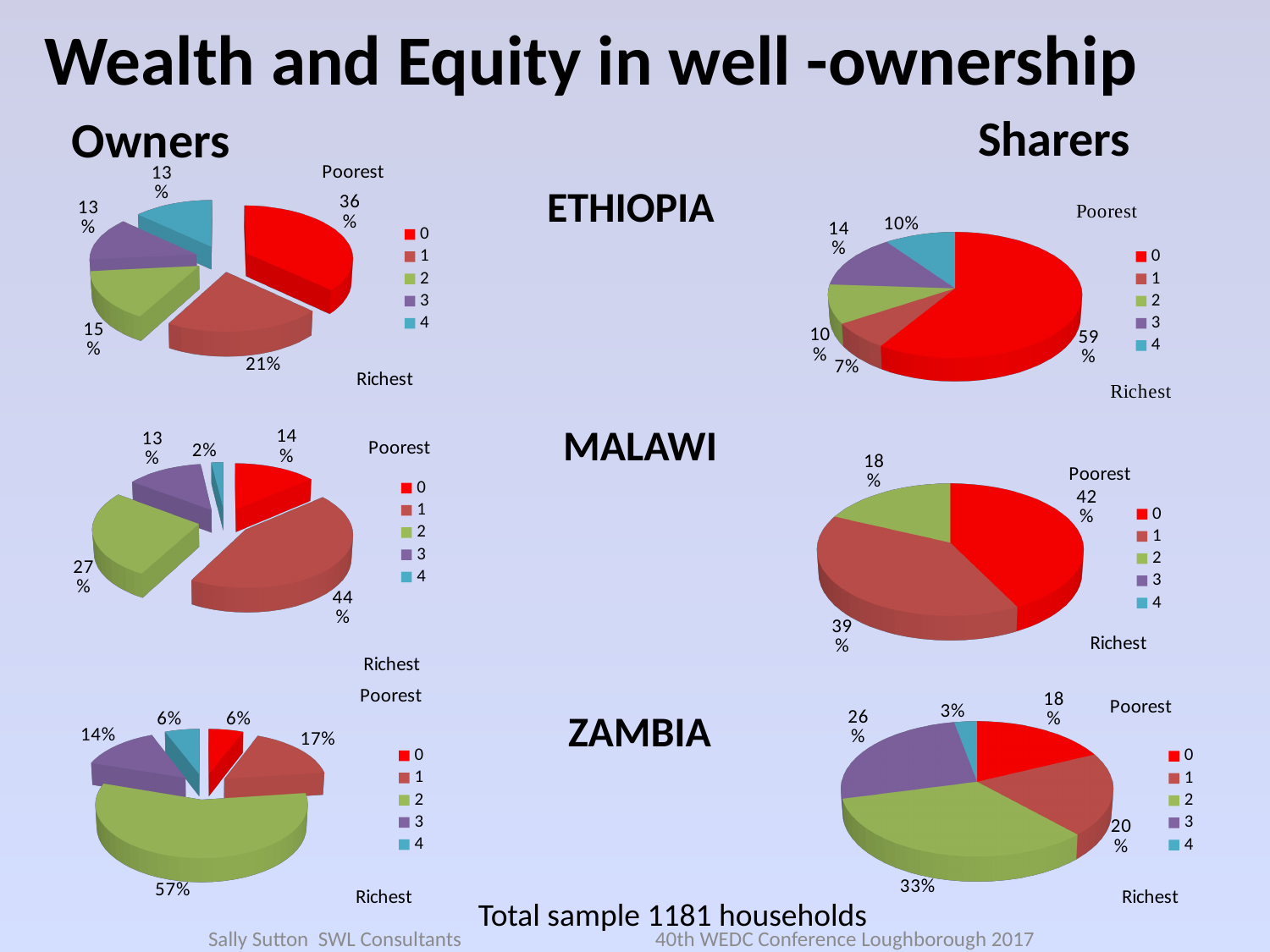
In the Malawi Owners pie chart, which category has the smallest share? 4 In the Ethiopia Owners pie chart, what share does category 0 (Poorest) have? 36% In the Ethiopia Sharers pie chart, what is the difference between the share for category 0 and the share for category 1? 52% What type of chart is used for the Zambia Sharers data? Pie chart In the Malawi Owners pie chart, which category has the largest share? 1 In the Ethiopia Sharers pie chart, what share does category 0 (Poorest) have? 59% How many series does the legend list in the Ethiopia Owners pie chart? 5 In the Zambia Sharers pie chart, what is the difference between the share for category 2 and the share for category 0? 15% In the Malawi Sharers pie chart, which is larger: the share for category 0 or the share for category 1? Category 0 In the Malawi Sharers pie chart, what share does category 2 have? 18% What is the total sample size stated at the bottom of the slide? 1181 households In the Zambia Owners pie chart, what share does category 2 have? 57%